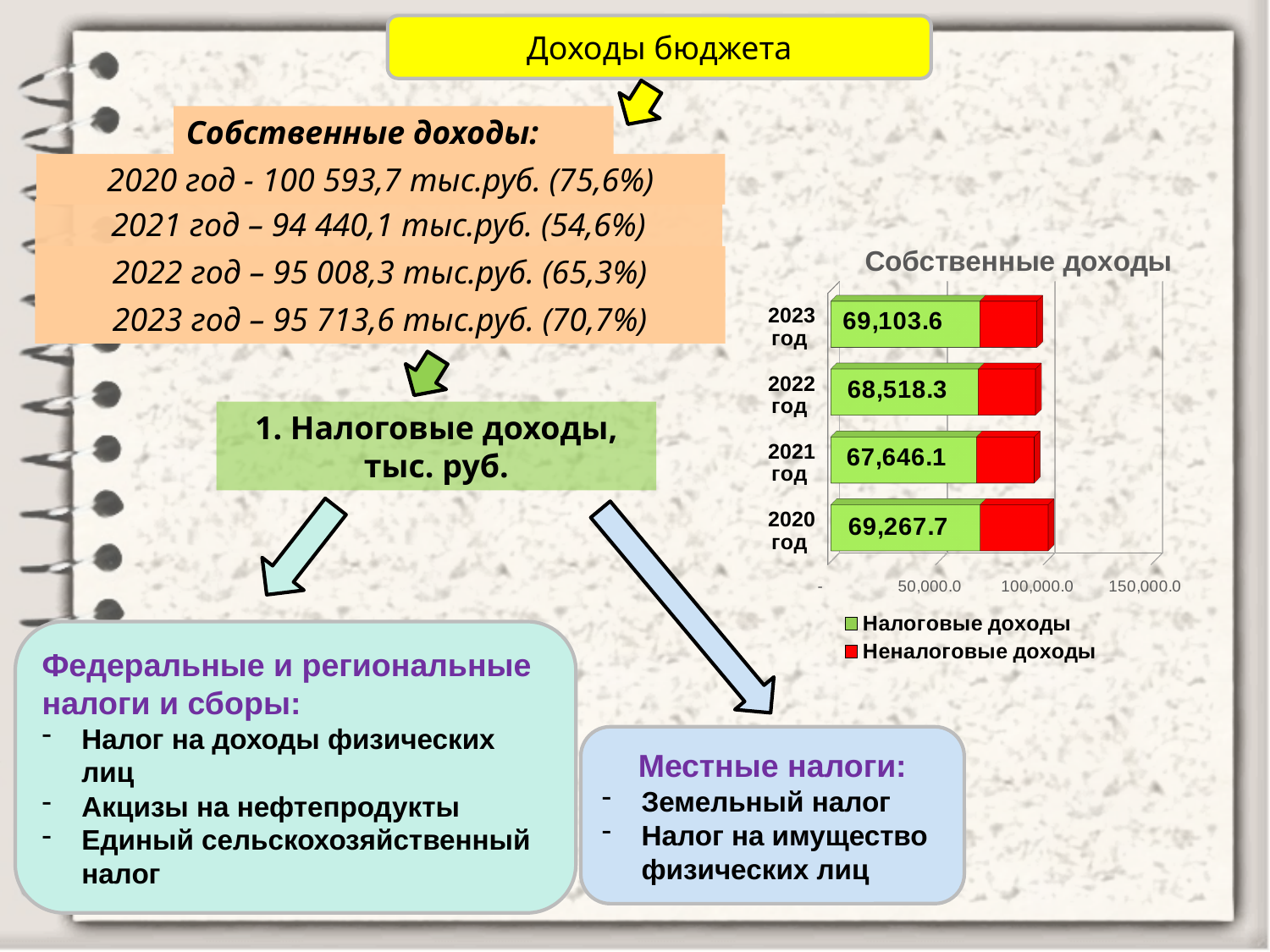
Which year has the lowest value of Налоговые доходы? 2021 год How many years are shown on the chart? 4 Is the value of Неналоговые доходы for 2020 год greater or less than 50,000.0? less Which year has the highest value of Налоговые доходы? 2020 год What type of chart is shown under the title "Собственные доходы"? bar chart What is the difference between Налоговые доходы in 2023 год and 2022 год? 585.3 What is the value of Налоговые доходы for 2020 год? 69,267.7 What is the value of Налоговые доходы for 2021 год? 67,646.1 What is the value of Налоговые доходы for 2023 год? 69,103.6 Which is larger, Налоговые доходы in 2022 год or in 2021 год? 2022 год What colour represents Неналоговые доходы in the chart? red How many series does the legend list? 2